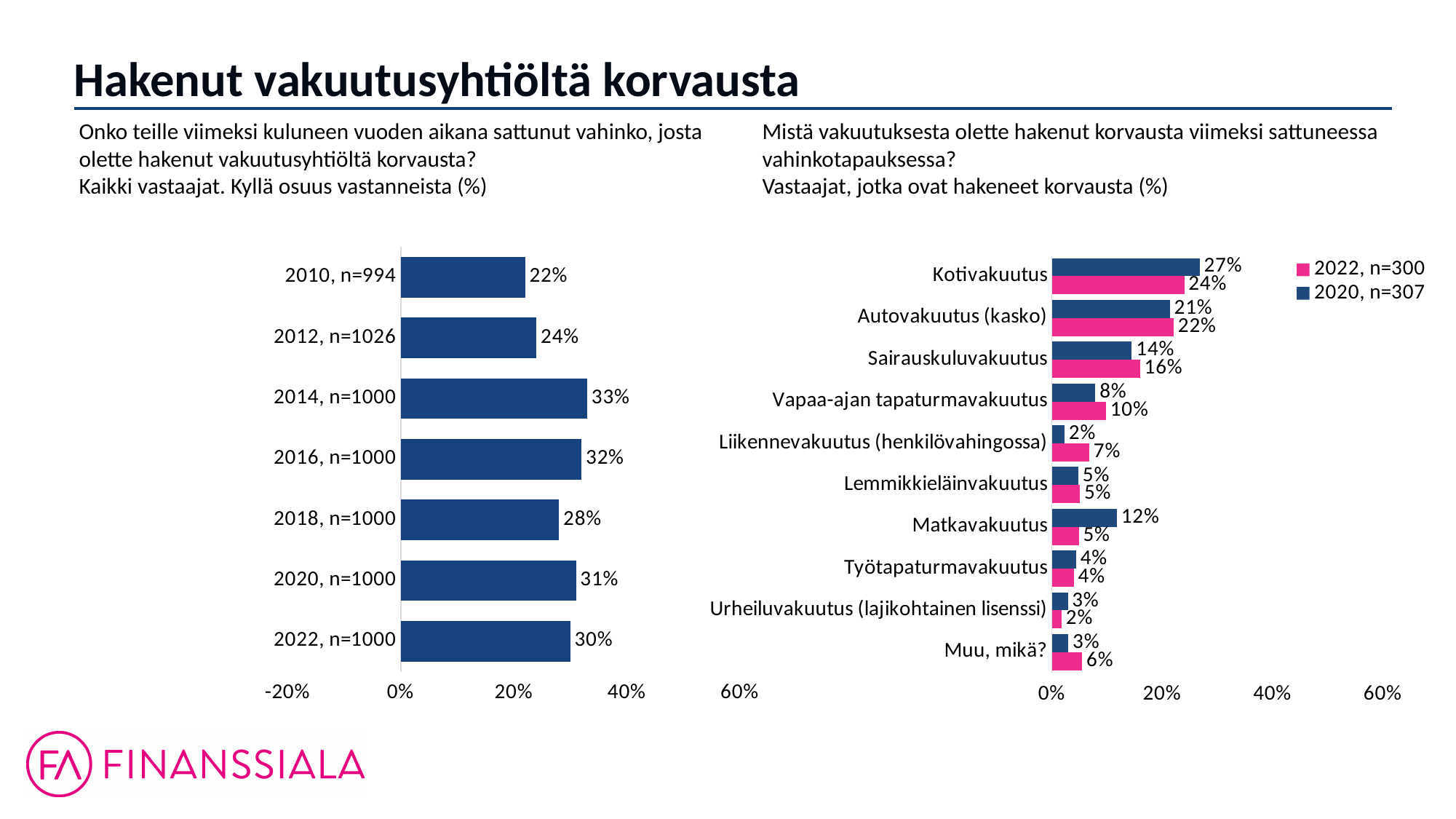
In the left chart, what is the difference between the values for 2014 and 2010? 11 percentage points In the right chart, what is the 2020 value for Matkavakuutus? 12% In the left chart, what is the value for 2014, n=1000? 33% In the right chart, what is the difference between the 2020 and 2022 values for Matkavakuutus? 7 percentage points In the right chart, which is larger for Liikennevakuutus (henkilövahingossa): the 2022 value or the 2020 value? 2022 What type of chart is the left chart? Bar chart In the right chart, which category has the highest 2020 value? Kotivakuutus How many bars does the left chart have? 7 In the left chart, which year has the highest value? 2014, n=1000 In the left chart, which year has the lowest value? 2010, n=994 In the right chart, what is the 2022 value for Kotivakuutus? 24% How many series does the legend of the right chart list? 2